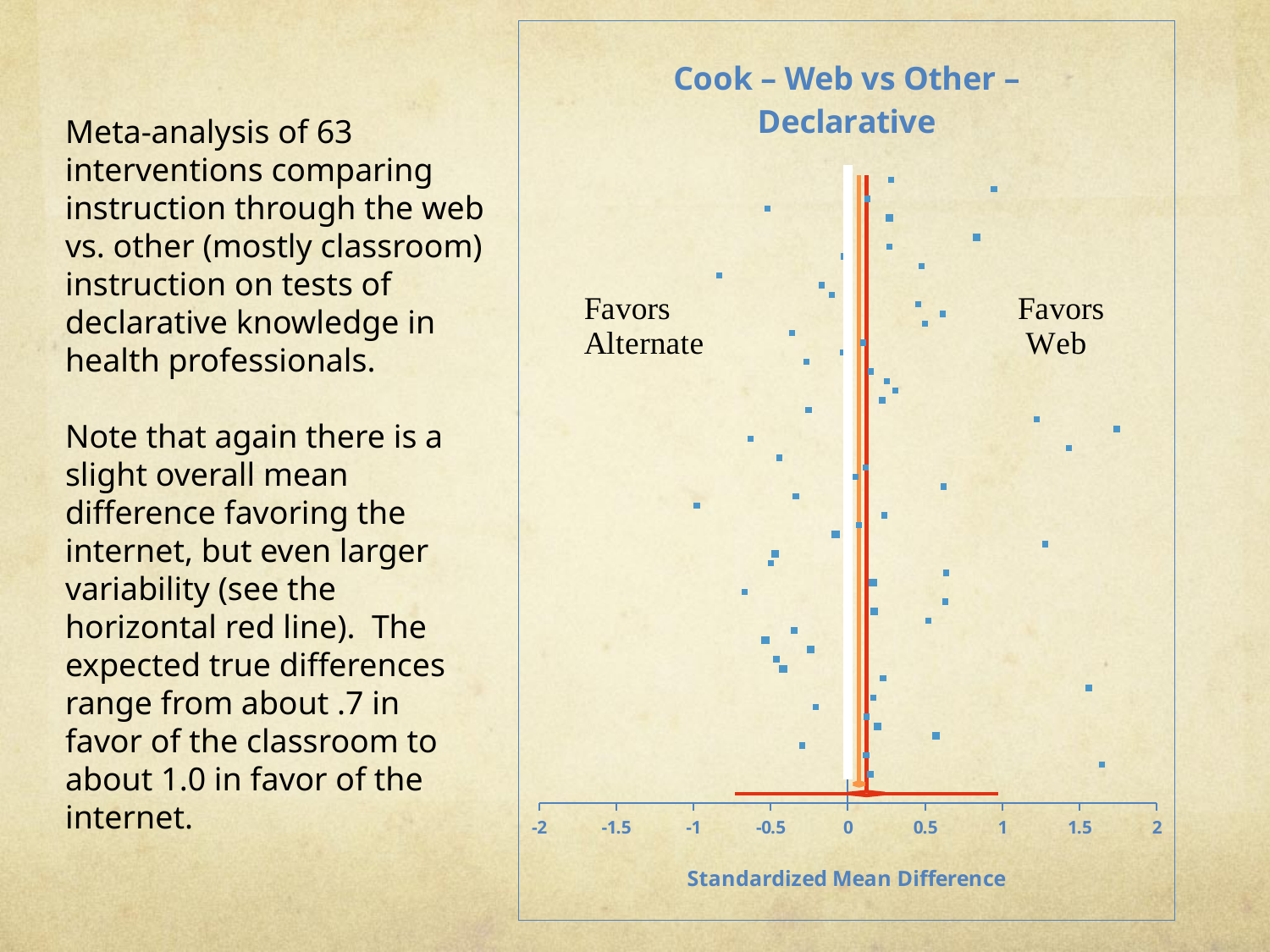
What is the title of the chart? Cook – Web vs Other – Declarative How many tick labels are shown on the horizontal axis of the chart? 9 Are there more plotted points to the right of 0 or to the left of 0 on the horizontal axis? right Is the leftmost plotted point in the chart greater or less than -0.5 on the horizontal axis? less Which side of the chart is labelled 'Favors Web', the left or the right? right What kind of chart is shown on the slide? scatter plot What is the label of the horizontal axis of the chart? Standardized Mean Difference What is the lowest value shown on the horizontal axis of the chart? -2 What is the highest value shown on the horizontal axis of the chart? 2 Is the vertical orange line marking the overall mean difference greater or less than 0? greater Is the rightmost plotted point in the chart greater or less than 1.5 on the horizontal axis? greater How many interventions are plotted in the chart, according to the slide? 63